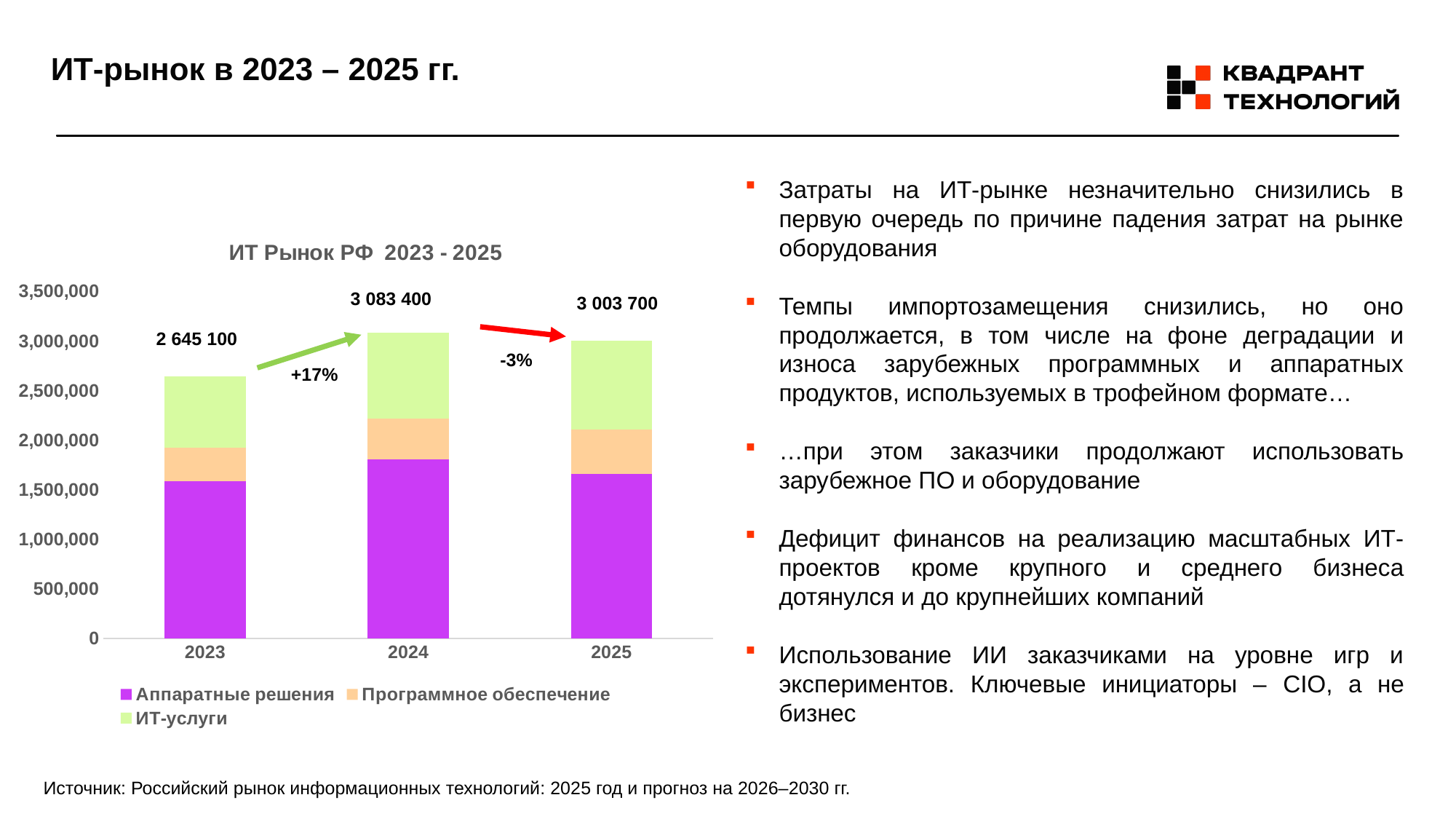
What is the difference between the total for 2024 and the total for 2023? 438 300 What percentage change is shown between 2024 and 2025? -3% What is the total value of the bar for 2025? 3 003 700 What is the total value of the bar for 2023? 2 645 100 Which is larger, the total for 2024 or the total for 2025? 2024 How many years are shown on the x axis? 3 How many series does the legend list? 3 Which year has the lowest total value? 2023 Is the value for Аппаратные решения in 2024 greater or less than 1,500,000? greater Which year has the highest total value? 2024 What kind of chart is shown? Stacked bar chart What is the total value of the bar for 2024? 3 083 400